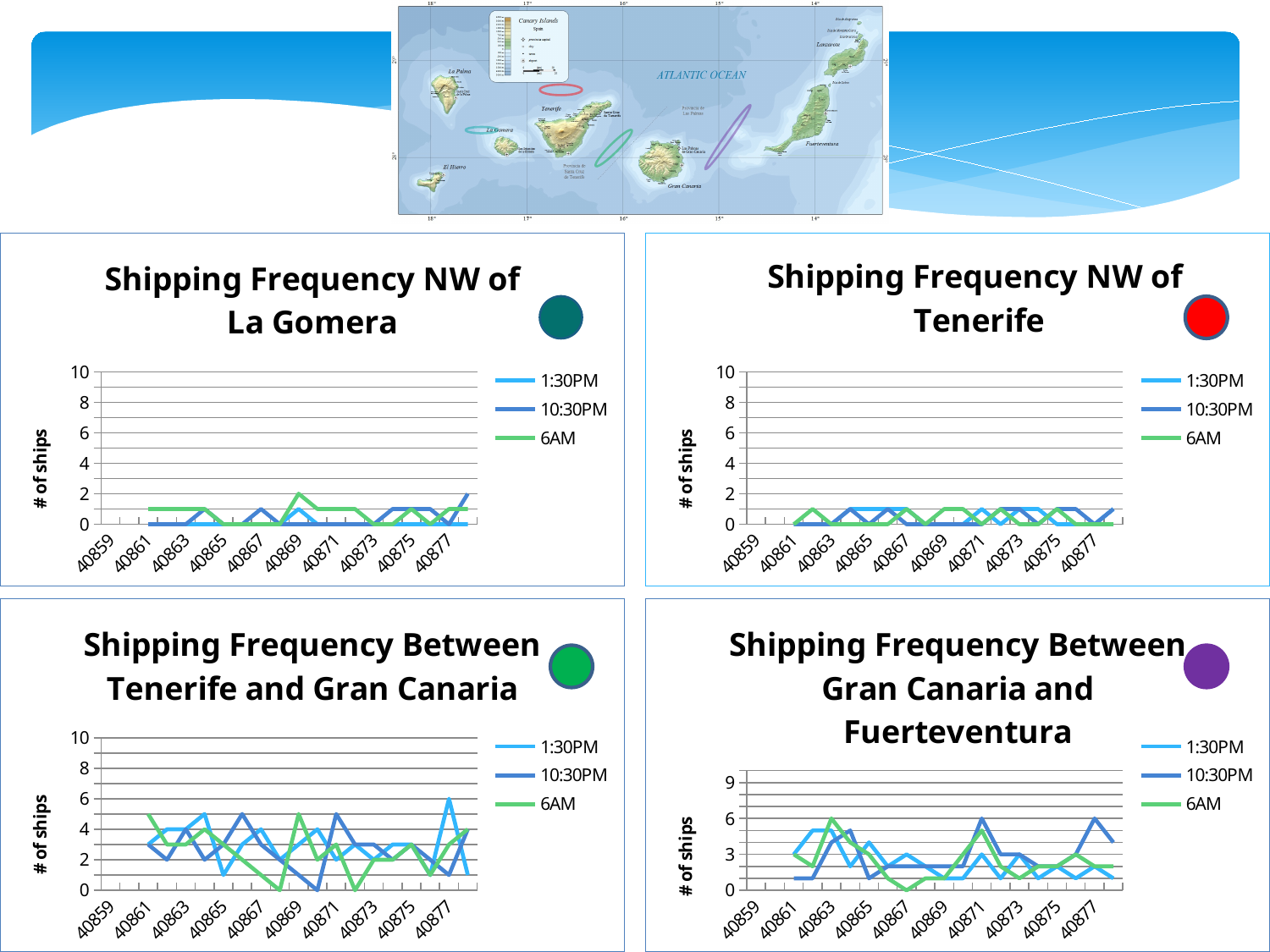
In "Shipping Frequency NW of La Gomera", is the highest value of the 6AM series greater or less than 4? less How many series does the legend of "Shipping Frequency NW of Tenerife" list? 3 In "Shipping Frequency NW of Tenerife", is the highest value of the 10:30PM series greater or less than 2? less In "Shipping Frequency Between Tenerife and Gran Canaria", which series reaches the highest value? 1:30PM What kind of chart is "Shipping Frequency NW of La Gomera"? line chart What kind of chart is "Shipping Frequency Between Gran Canaria and Fuerteventura"? line chart In "Shipping Frequency Between Gran Canaria and Fuerteventura", is the highest value of the 10:30PM series greater or less than 3? greater What are the legend entries in "Shipping Frequency Between Tenerife and Gran Canaria"? 1:30PM, 10:30PM, 6AM What is the highest value shown on the y axis of "Shipping Frequency Between Gran Canaria and Fuerteventura"? 9 How many charts are shown on the slide? 4